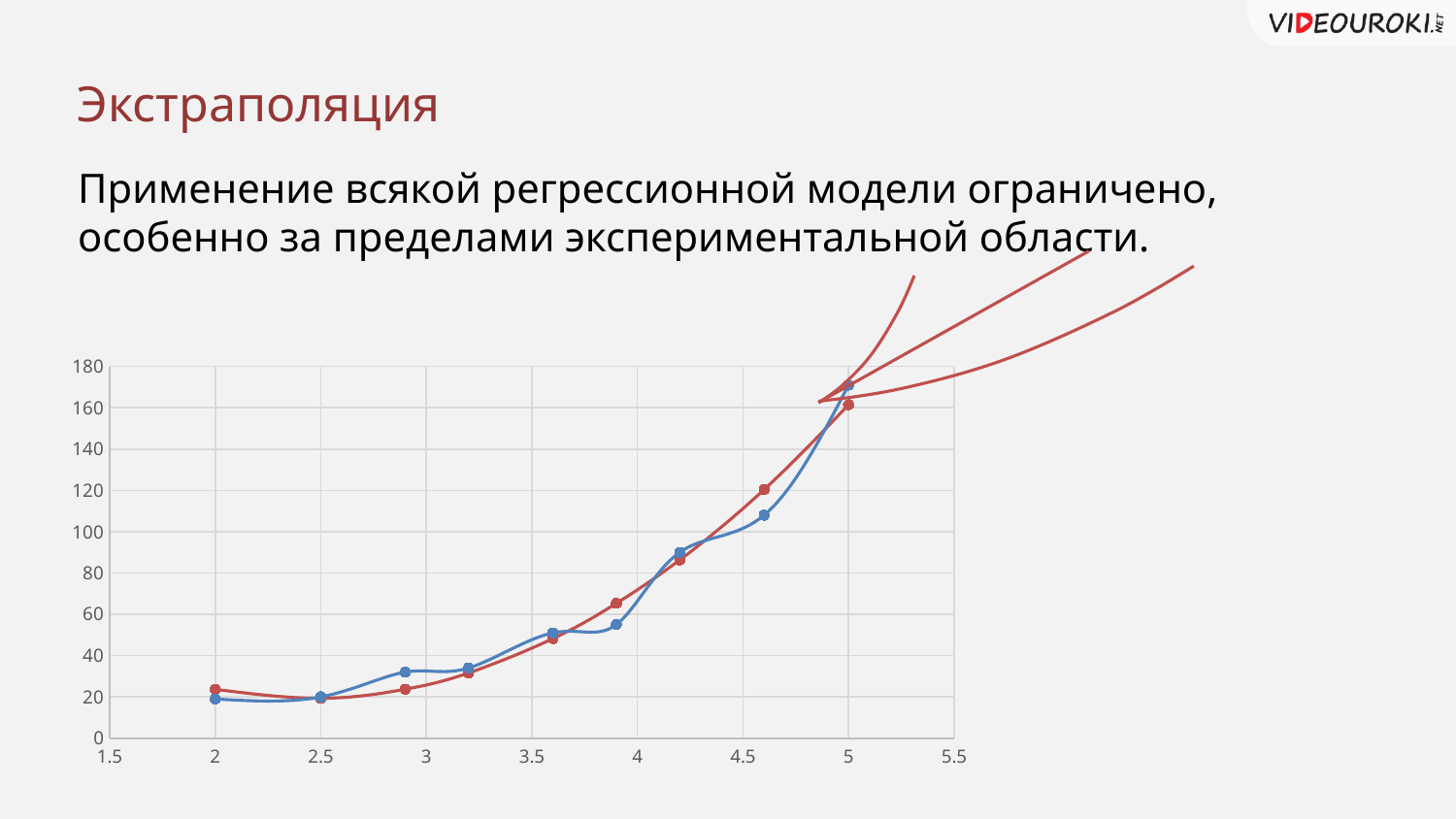
What kind of chart is shown on the slide? line chart Is the value of the blue series at x = 4.2 greater or less than 80? greater Is the value of the red series at x = 4.6 greater or less than 100? greater How many data series are plotted on the chart? 2 What is the highest value shown on the vertical axis of the chart? 180 At x = 2.9, which series has the larger value, the blue or the red? blue How many data points does the blue series have? 9 Is the value of the blue series at x = 5 greater or less than 160? greater Do the values of the blue series generally rise or fall as x increases from 2 to 5? rise At x = 4.6, which series has the larger value, the blue or the red? red